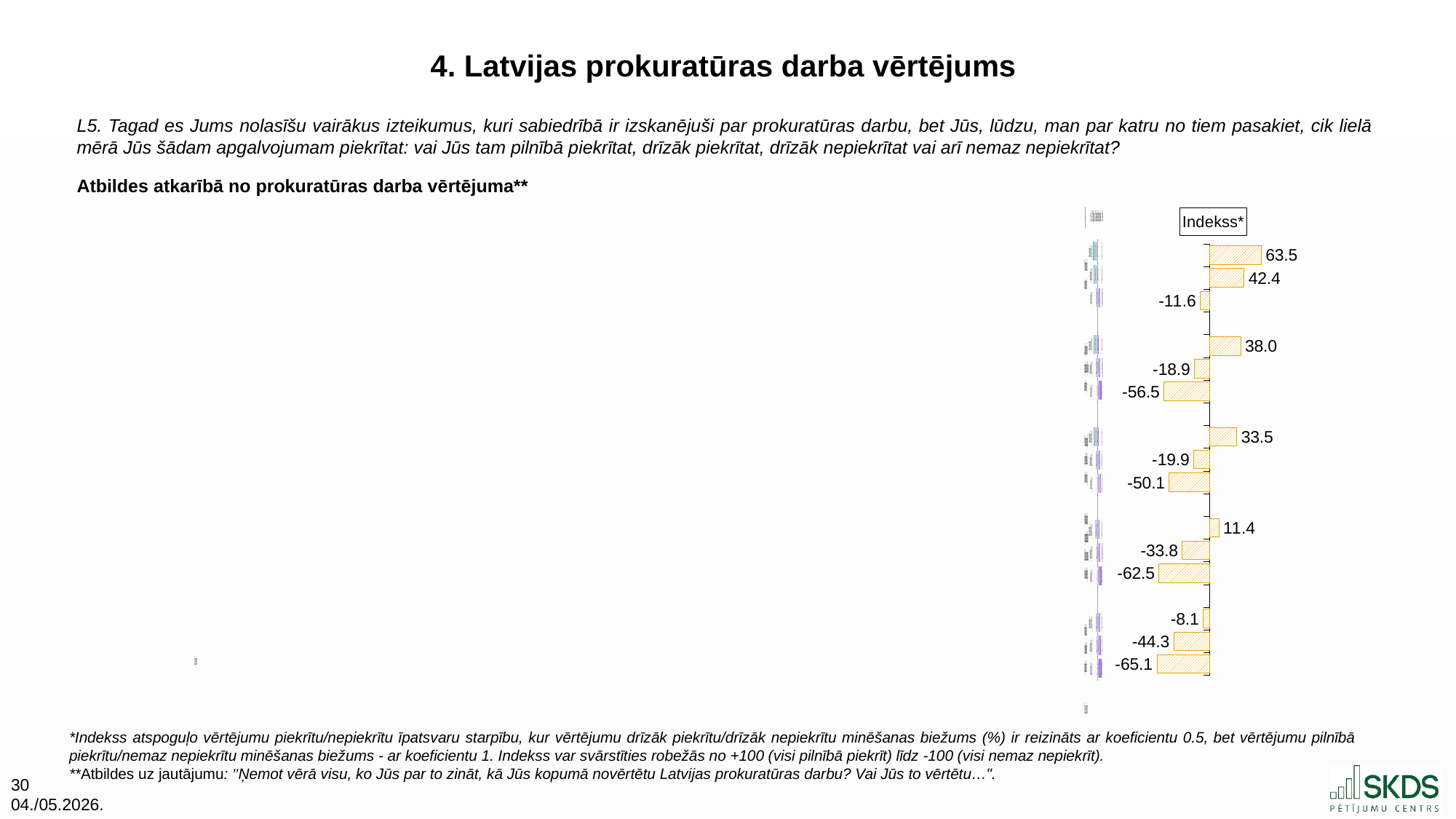
How many bars are plotted in the Indekss* chart? 15 In the Indekss* chart, what is the value of the third bar from the top? -11.6 What kind of chart is the Indekss* chart on the right side of the slide? bar chart In the Indekss* chart, what is the highest value shown? 63.5 In the Indekss* chart, what is the value of the bottom bar? -65.1 In the Indekss* chart, what is the difference between the two topmost bars (63.5 and 42.4)? 21.1 How many bars in the Indekss* chart have a negative value? 10 What label appears in the box above the bar chart on the right side of the slide? Indekss* How many bars in the Indekss* chart have a positive value? 5 In the Indekss* chart, which is larger: the bar labelled 38.0 or the bar labelled 33.5? 38.0 In the Indekss* chart, what is the value of the topmost bar? 63.5 In the Indekss* chart, what is the lowest value shown? -65.1